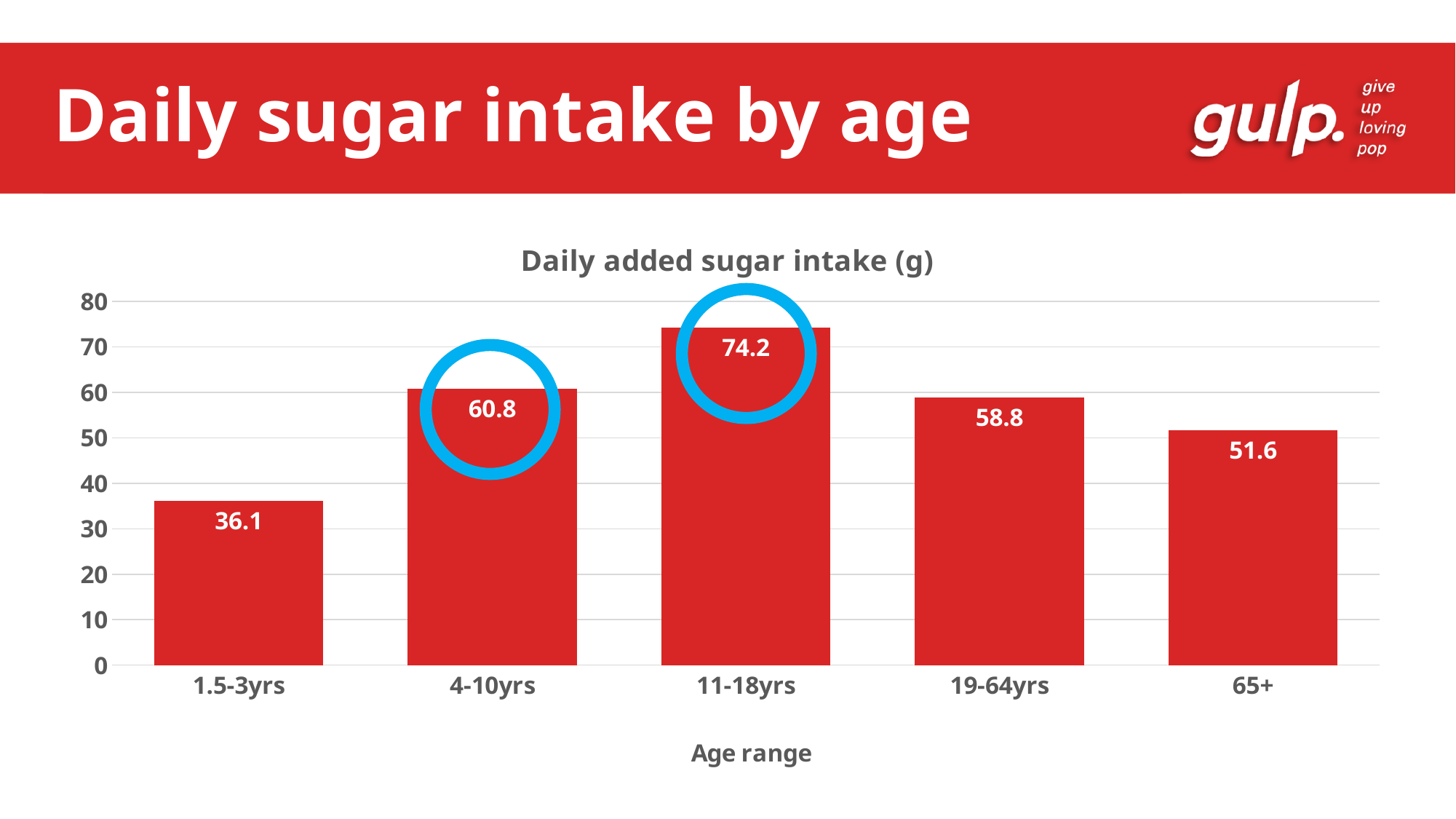
What kind of chart is shown on the slide? Bar chart Which age range has the lowest daily added sugar intake? 1.5-3yrs What is the daily added sugar intake for the 1.5-3yrs age range? 36.1 What is the daily added sugar intake for the 65+ age range? 51.6 What is the title of the chart? Daily added sugar intake (g) What is the difference in daily added sugar intake between the 11-18yrs and 4-10yrs age ranges? 13.4 What is the daily added sugar intake for the 4-10yrs age range? 60.8 Is the value for 1.5-3yrs greater or less than 40? less Which has a higher daily added sugar intake, 4-10yrs or 19-64yrs? 4-10yrs What is the difference in daily added sugar intake between the 19-64yrs and 65+ age ranges? 7.2 Which age range has the highest daily added sugar intake? 11-18yrs How many age ranges are shown on the chart? 5